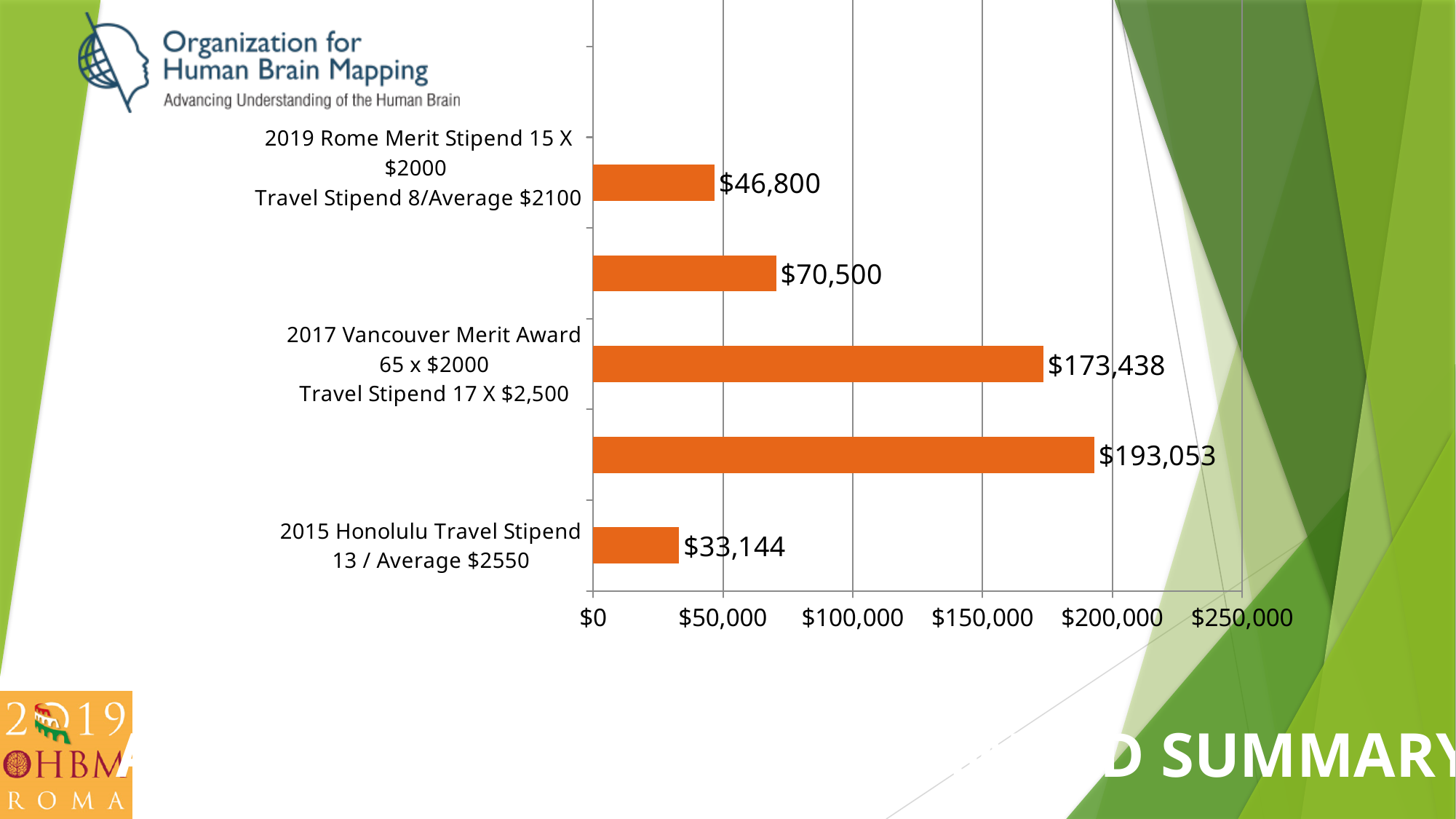
What is the value of the bar labelled 2019 Rome Merit Stipend 15 X $2000 / Travel Stipend 8/Average $2100? $46,800 What is the difference between the 2019 Rome Merit Stipend bar ($46,800) and the 2015 Honolulu Travel Stipend bar ($33,144)? $13,656 What is the difference between the 2017 Vancouver Merit Award bar ($173,438) and the 2019 Rome Merit Stipend bar ($46,800)? $126,638 Is the value for the 2019 Rome Merit Stipend bar greater or less than $50,000? less What is the value of the bar labelled 2015 Honolulu Travel Stipend 13 / Average $2550? $33,144 What is the maximum value shown on the horizontal axis of the chart? $250,000 Which is larger: the 2019 Rome Merit Stipend bar or the 2015 Honolulu Travel Stipend bar? 2019 Rome Merit Stipend What is the largest value shown by any bar in the chart? $193,053 How many bars are plotted in the chart? 5 What is the value of the bar labelled 2017 Vancouver Merit Award 65 x $2000 / Travel Stipend 17 X $2,500? $173,438 Which labelled category has the lowest value in the chart? 2015 Honolulu Travel Stipend 13 / Average $2550 What type of chart is shown on the slide? bar chart